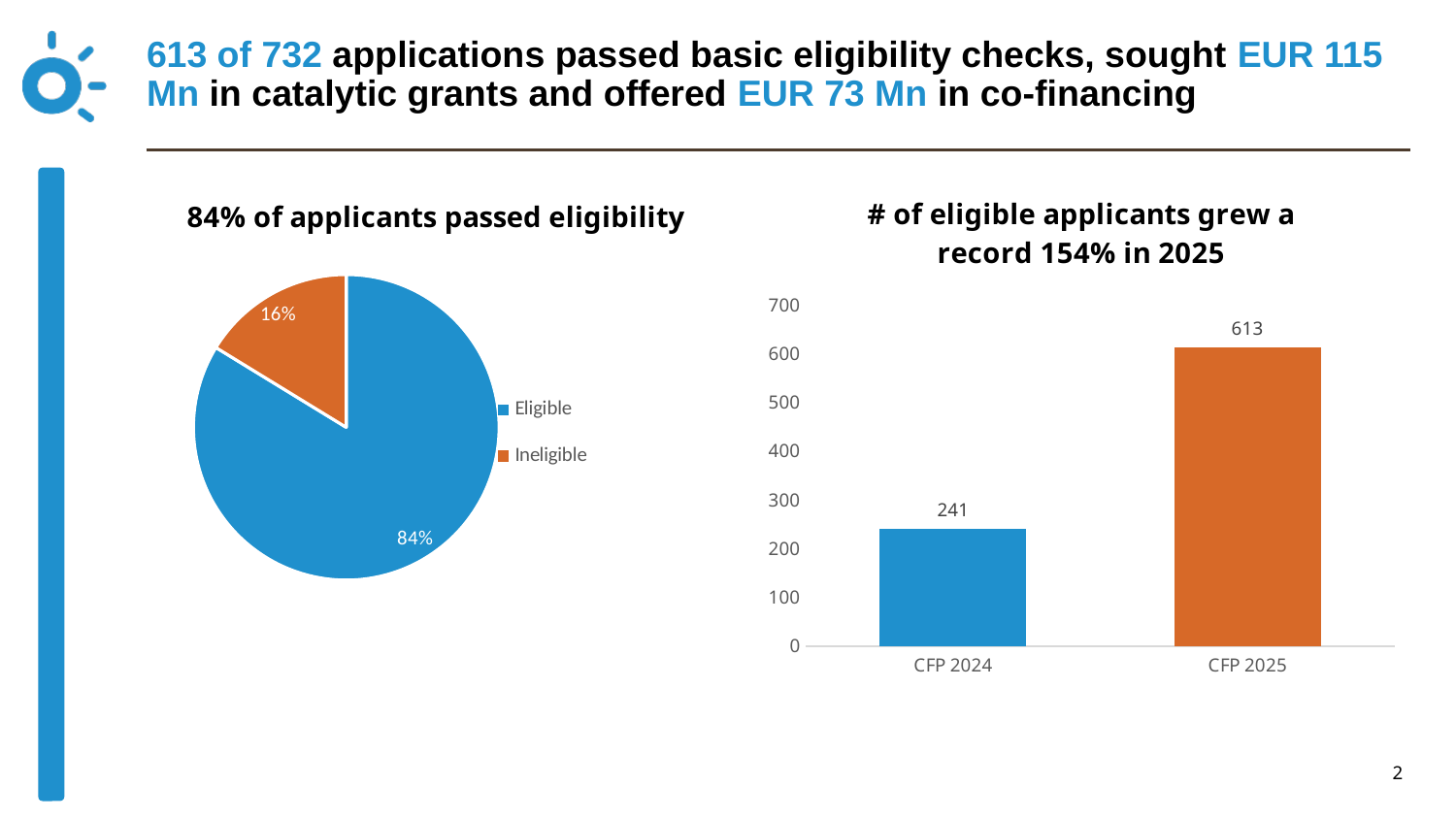
How many categories are shown on the x axis of the bar chart on the right? 2 In the bar chart on the right, which category has the lowest value? CFP 2024 In the pie chart titled '84% of applicants passed eligibility', what share of applicants is Ineligible? 16% In the bar chart on the right, which category has the highest value? CFP 2025 In the bar chart on the right, what is the difference between the values for CFP 2025 and CFP 2024? 372 In the chart titled '# of eligible applicants grew a record 154% in 2025', what is the value for CFP 2024? 241 In the pie chart titled '84% of applicants passed eligibility', what share of applicants is Eligible? 84% In the pie chart on the left, which slice is larger, Eligible or Ineligible? Eligible How many entries does the legend of the pie chart on the left list? 2 In the chart titled '# of eligible applicants grew a record 154% in 2025', what is the value for CFP 2025? 613 What kind of chart is the chart on the right of the slide? Bar chart What kind of chart is the chart on the left of the slide? Pie chart